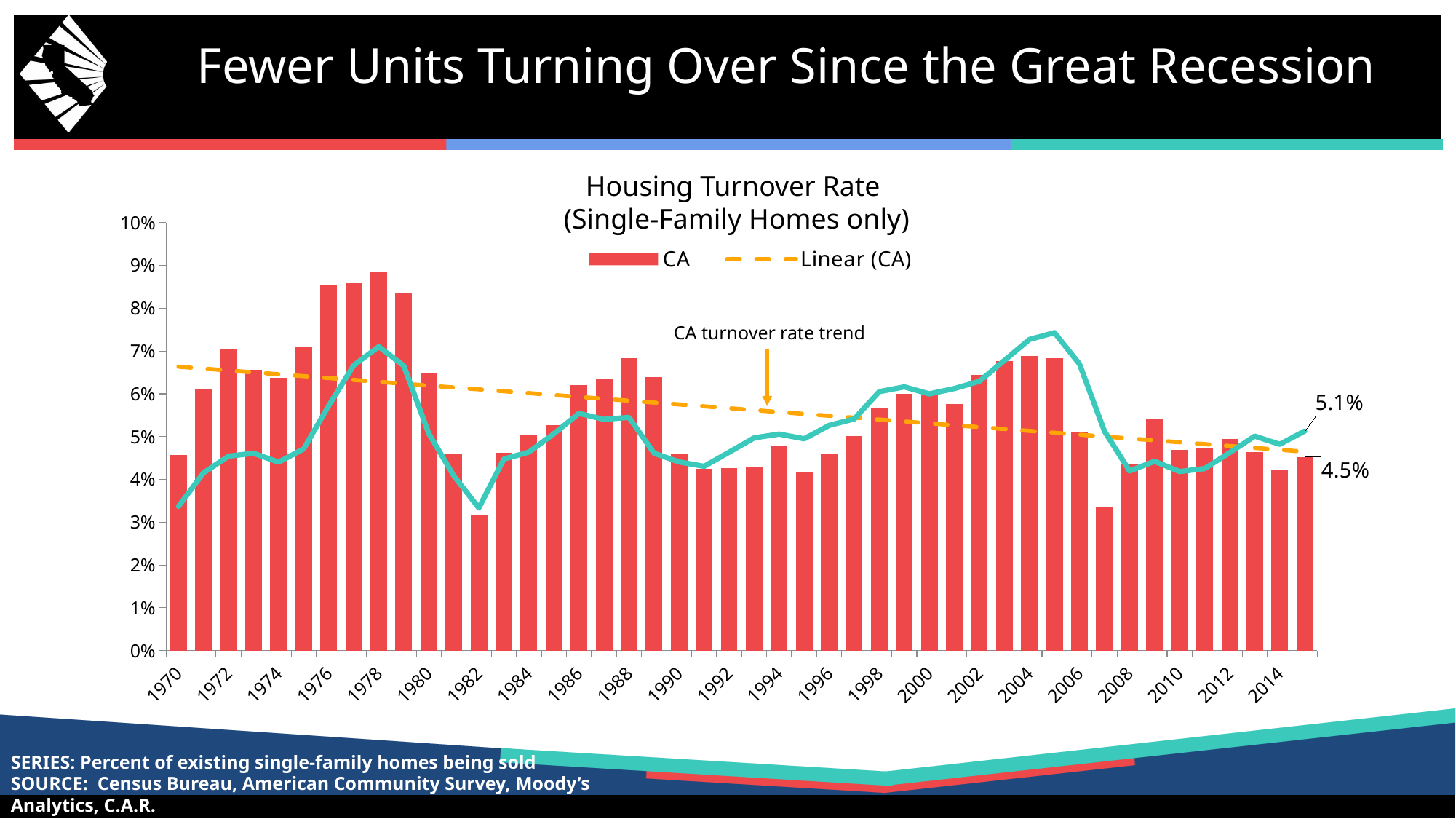
Which year has the highest housing turnover rate bar? 1978 How many series does the chart legend list? 2 Does the dashed linear trend line rise or fall from 1970 to 2015? Fall Is the turnover rate for 2007 greater or less than 4%? less What is the title of the chart? Housing Turnover Rate (Single-Family Homes only) Is the turnover rate for 1982 greater or less than 4%? less Is the turnover rate for 2004 greater or less than 6%? greater What kind of chart is shown on the slide? Combination bar and line chart Which year has the larger turnover rate, 2004 or 2014? 2004 What value is labelled at the right end of the teal CA turnover rate trend line? 5.1% Which year has the larger turnover rate, 1978 or 1988? 1978